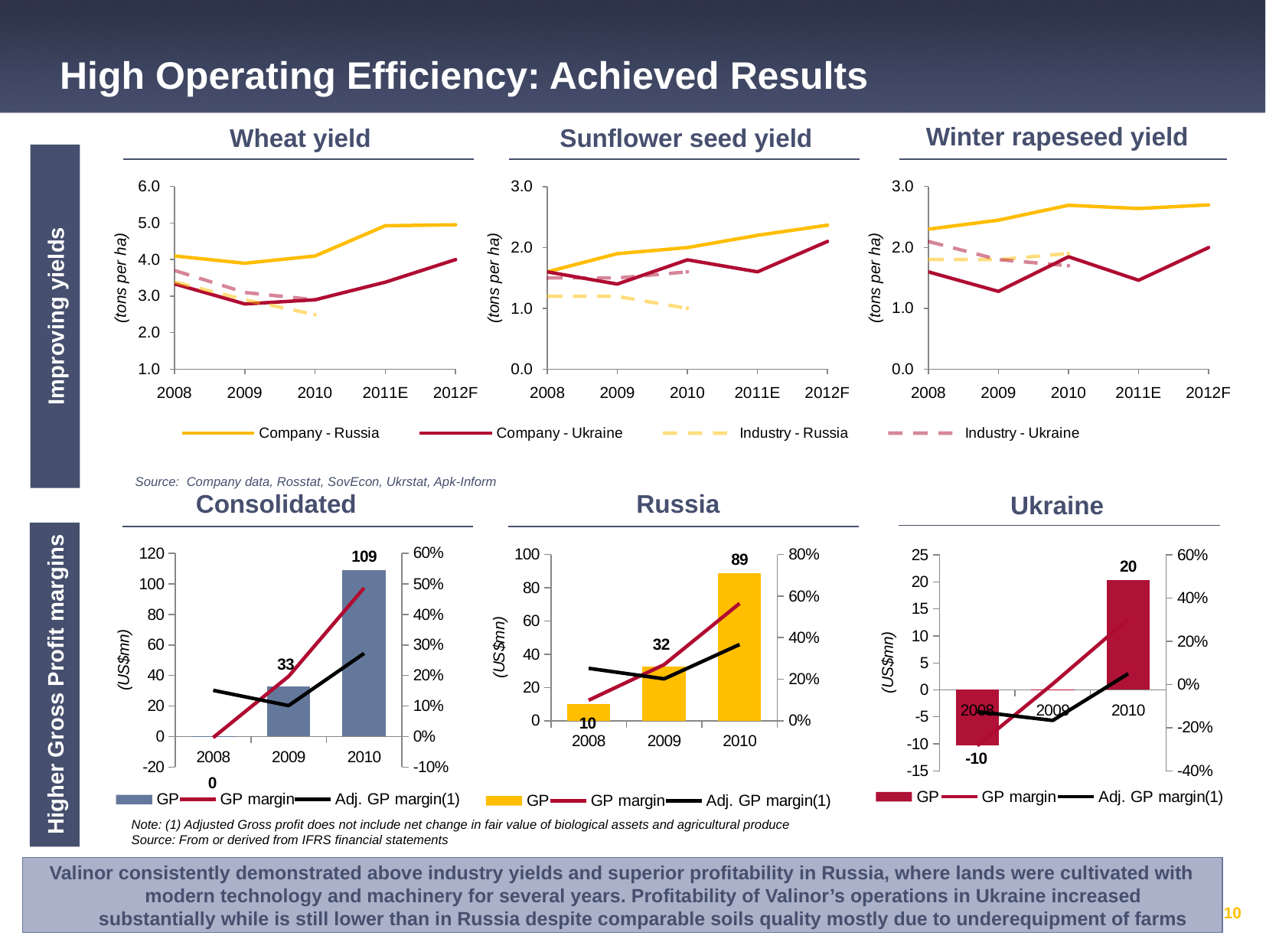
In the Consolidated chart, what is the difference between the GP values for 2010 and 2009? 76 In the Ukraine chart, what is the GP value for 2008? -10 How many years are shown on the x axis of the Sunflower seed yield chart? 5 In the Russia chart, what is the difference between the GP values for 2010 and 2008? 79 In the Russia chart, which year has the highest GP value? 2010 Which is larger: the 2010 GP value in the Russia chart or the 2010 GP value in the Ukraine chart? Russia In the Ukraine chart, which year has the lowest GP value? 2008 In the Wheat yield chart, is the Company - Russia value for 2012F greater or less than 4.0? greater In the Russia chart, what is the GP value for 2009? 32 What kind of chart is the Wheat yield chart? line chart How many series does the legend of the Wheat yield chart list? 4 In the Consolidated chart, what is the GP value for 2010? 109